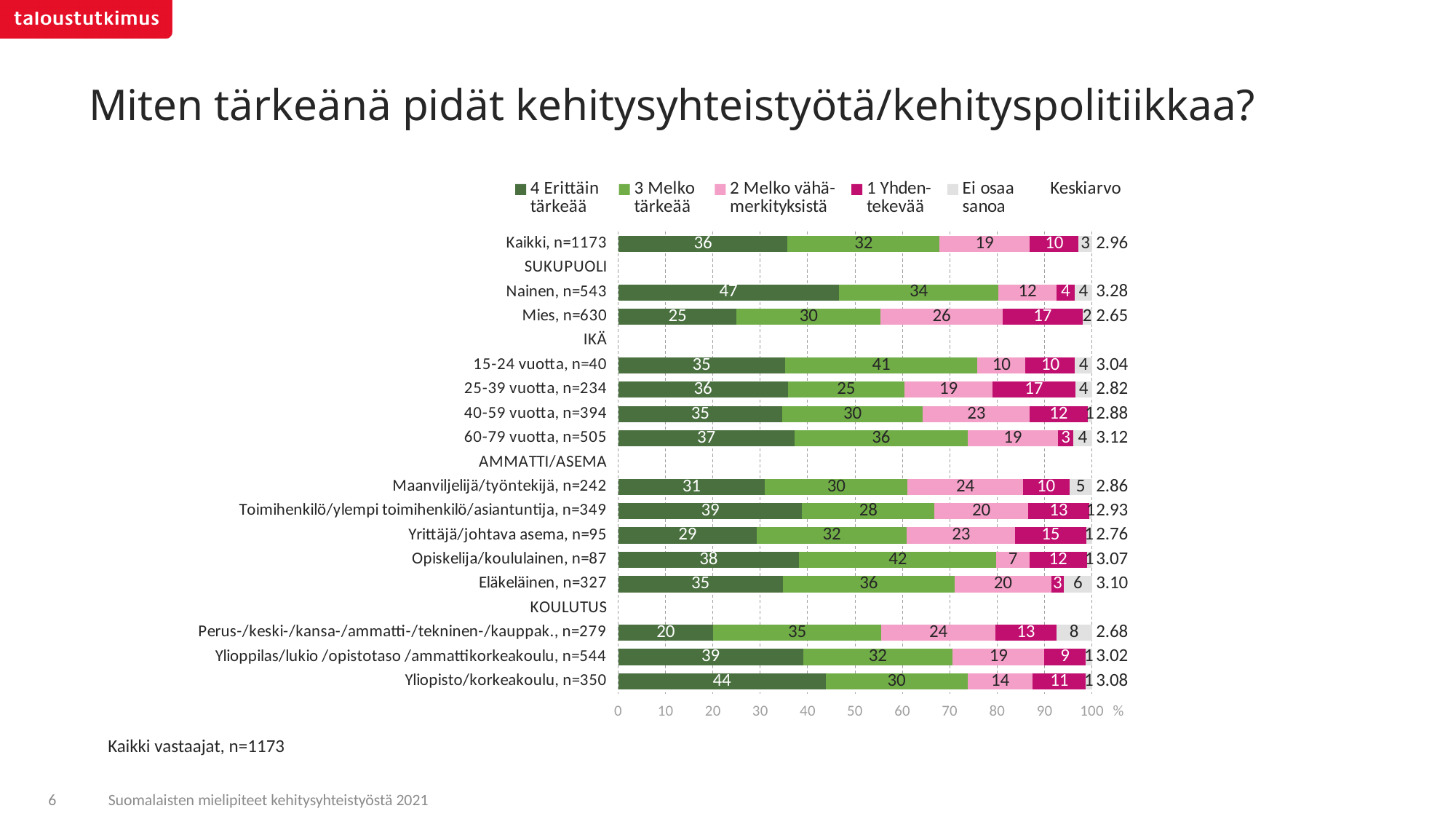
What is the total of the stacked bar for Kaikki, n=1173? 100 Which respondent group has the highest Keskiarvo value? Nainen, n=543 What percentage of Yliopisto/korkeakoulu, n=350 respondents answered '1 Yhdentekevää'? 11 Which group has a larger '3 Melko tärkeää' share: 60-79 vuotta, n=505 or 25-39 vuotta, n=234? 60-79 vuotta, n=505 What percentage of Eläkeläinen, n=327 respondents answered 'Ei osaa sanoa'? 6 What is the difference in the '4 Erittäin tärkeää' share between Nainen, n=543 and Mies, n=630? 22 What kind of chart is shown on the slide? Stacked bar chart How many respondent groups have bars plotted in the chart? 15 What is the title of the slide? Miten tärkeänä pidät kehitysyhteistyötä/kehityspolitiikkaa? What percentage of women (Nainen, n=543) answered '4 Erittäin tärkeää'? 47 Which respondent group has the lowest share of '4 Erittäin tärkeää' answers? Perus-/keski-/kansa-/ammatti-/tekninen-/kauppak., n=279 What is the Keskiarvo (mean) value for Mies, n=630? 2.65